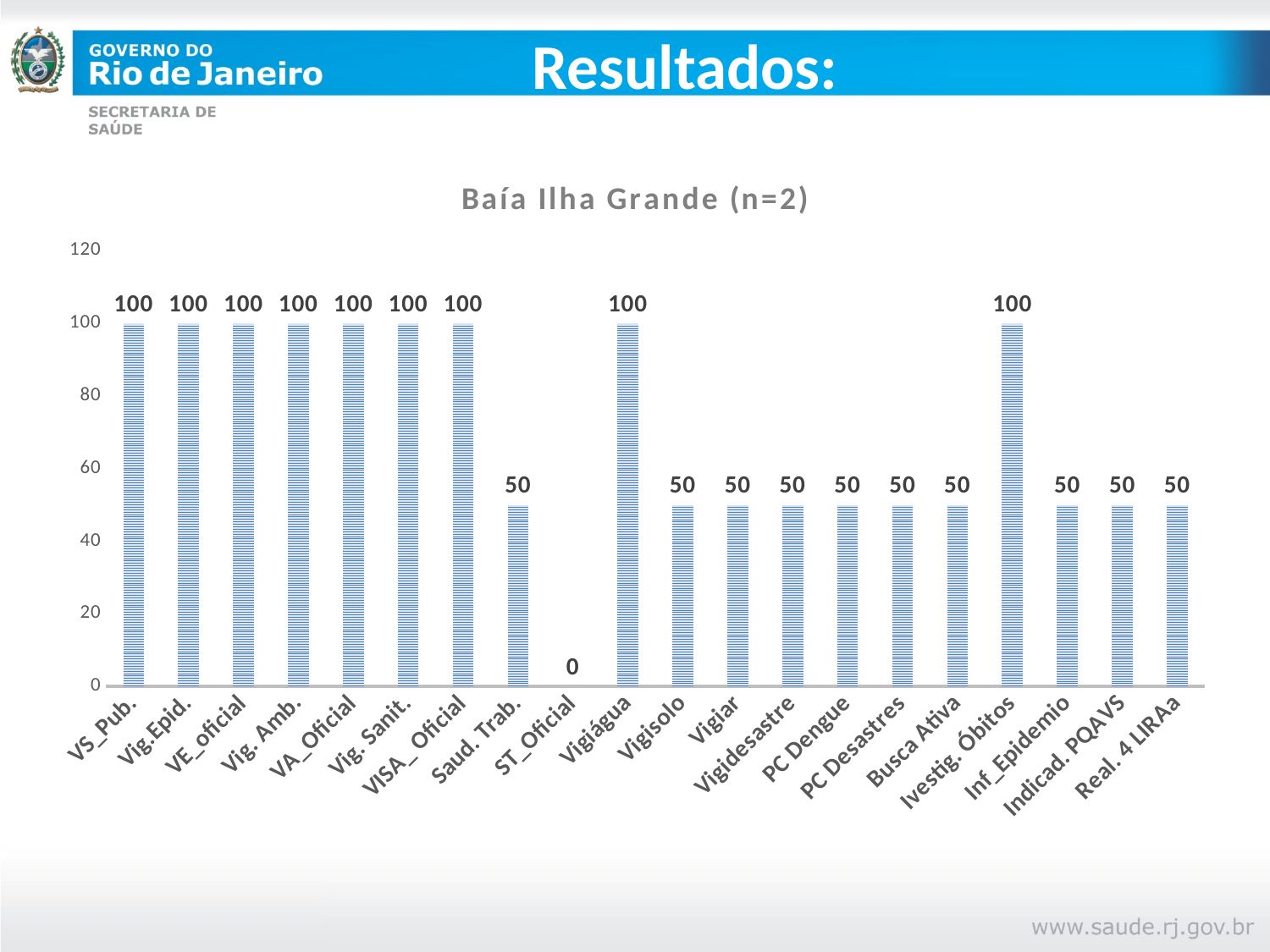
What is the value for Ivestig. Óbitos? 100 What is the value for ST_Oficial? 0 What is the value for Vigiágua? 100 What is the highest tick value shown on the y axis? 120 Which category has the lowest value? ST_Oficial What is the difference between the values for VS_Pub. and Vigisolo? 50 How many categories have a value of 100? 9 What is the title of the chart? Baía Ilha Grande (n=2) Which is larger, the value for PC Dengue or the value for Vig. Sanit.? Vig. Sanit. What is the value for Saud. Trab.? 50 What kind of chart is shown on the slide? Bar chart How many categories are shown on the x axis? 20